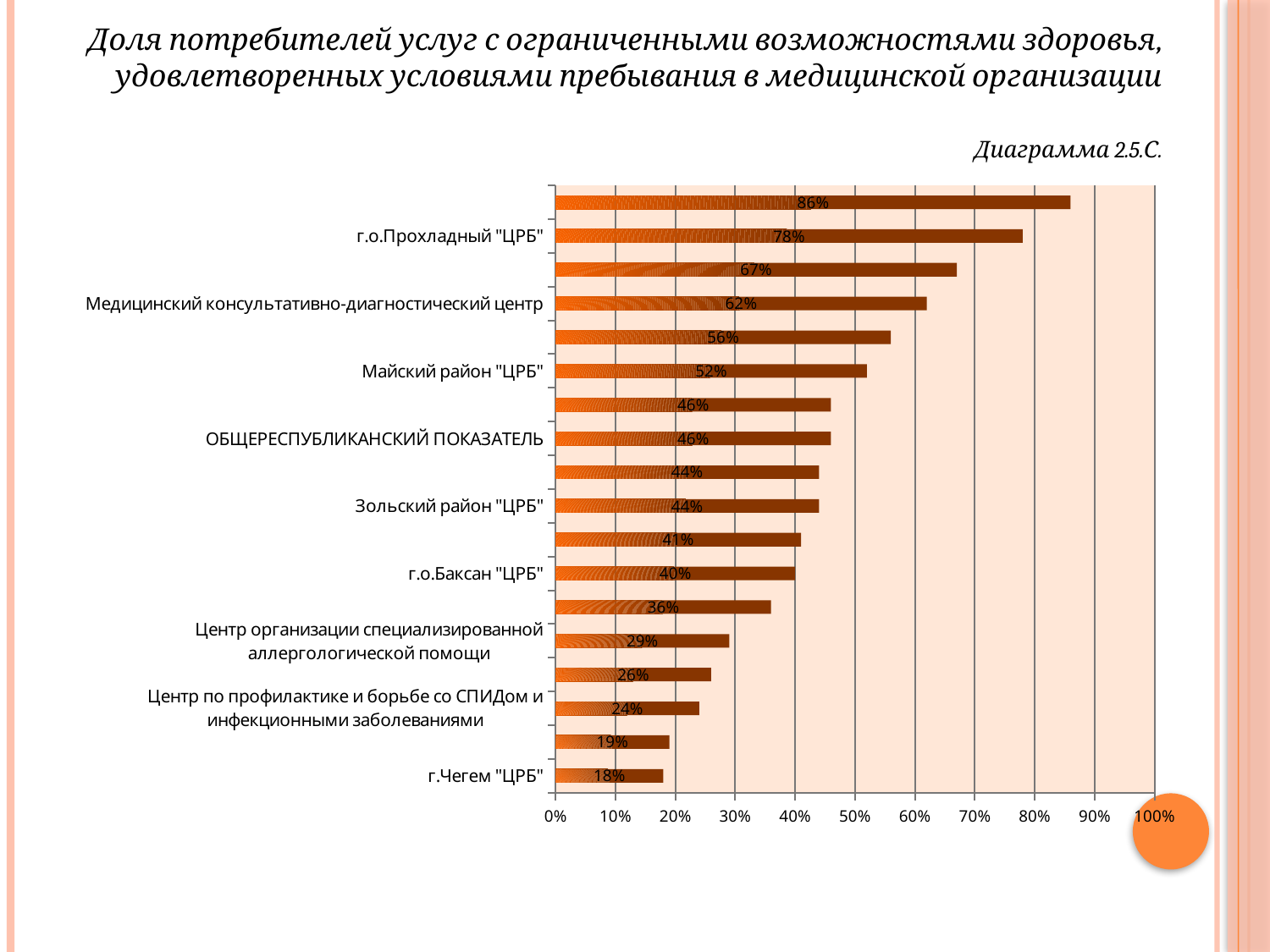
What is the value for г.Чегем "ЦРБ"? 18% What is the value for Майский район "ЦРБ"? 52% What is the value for ОБЩЕРЕСПУБЛИКАНСКИЙ ПОКАЗАТЕЛЬ? 46% What is the value for Медицинский консультативно-диагностический центр? 62% What is the difference between the values for г.о.Прохладный "ЦРБ" and Медицинский консультативно-диагностический центр? 16% What diagram number is given on the slide? Диаграмма 2.5.С. Which is larger, the value for Зольский район "ЦРБ" or the value for г.о.Баксан "ЦРБ"? Зольский район "ЦРБ" Which labelled category has the lowest value? г.Чегем "ЦРБ" What is the highest value shown on the chart? 86% What is the value for г.о.Прохладный "ЦРБ"? 78% How many bars are plotted on the chart? 18 What type of chart is shown on the slide? bar chart